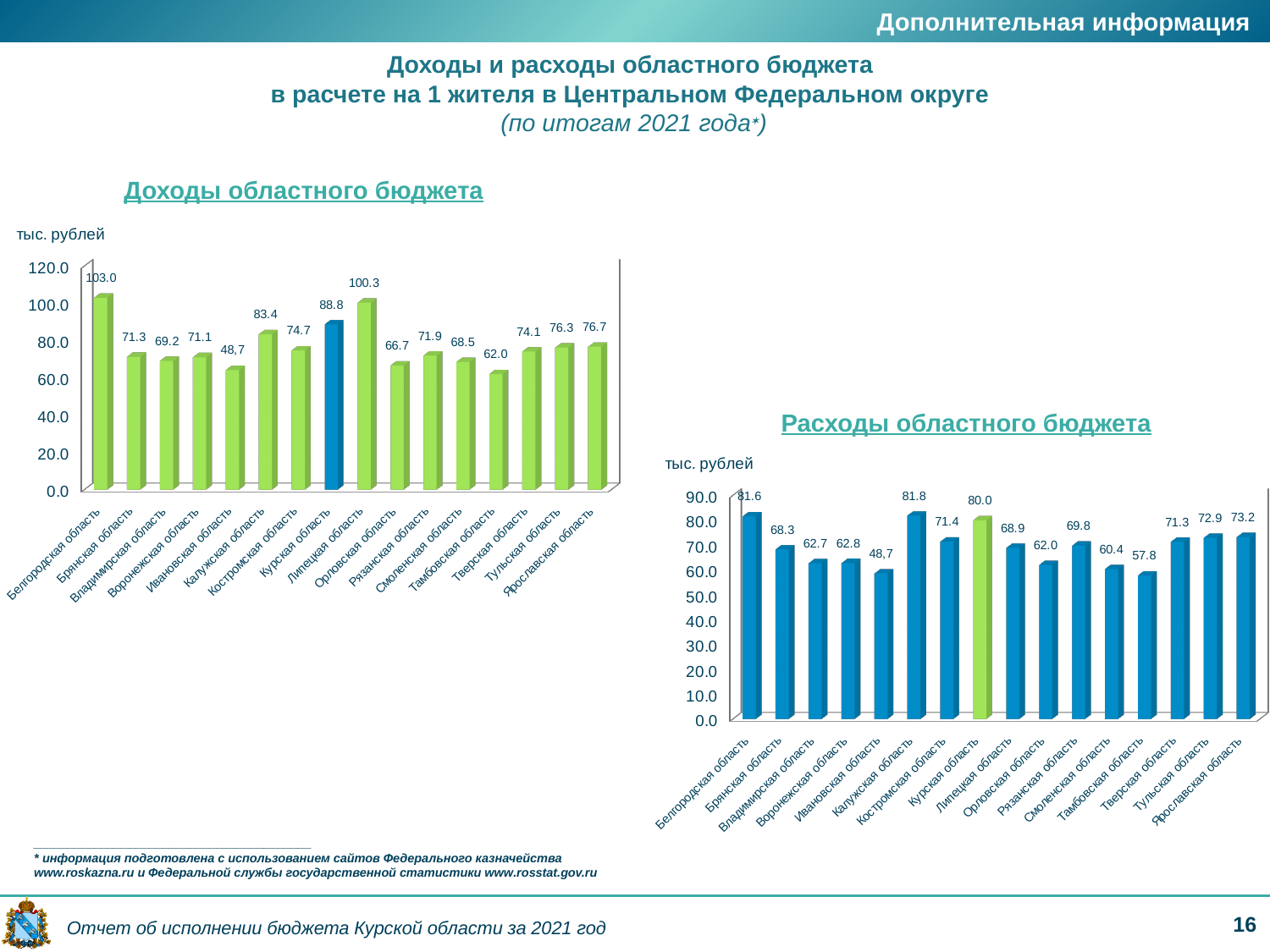
On the 'Доходы областного бюджета' chart, what is the difference between Белгородская область and Липецкая область? 2.7 What type of chart is the 'Расходы областного бюджета' chart? bar chart On the 'Расходы областного бюджета' chart, what is the value for Курская область? 80.0 On the 'Расходы областного бюджета' chart, is the value for Калужская область greater or less than 80.0? greater On the 'Расходы областного бюджета' chart, what is the difference between Курская область and Тамбовская область? 22.2 On the 'Расходы областного бюджета' chart, which is larger: Тульская область or Ярославская область? Ярославская область On the 'Доходы областного бюджета' chart, how many regions are shown? 16 On the 'Доходы областного бюджета' chart, what is the value for Курская область? 88.8 On the 'Доходы областного бюджета' chart, which region has the highest value? Белгородская область On the 'Доходы областного бюджета' chart, which region's bar is coloured differently (blue) from the others? Курская область